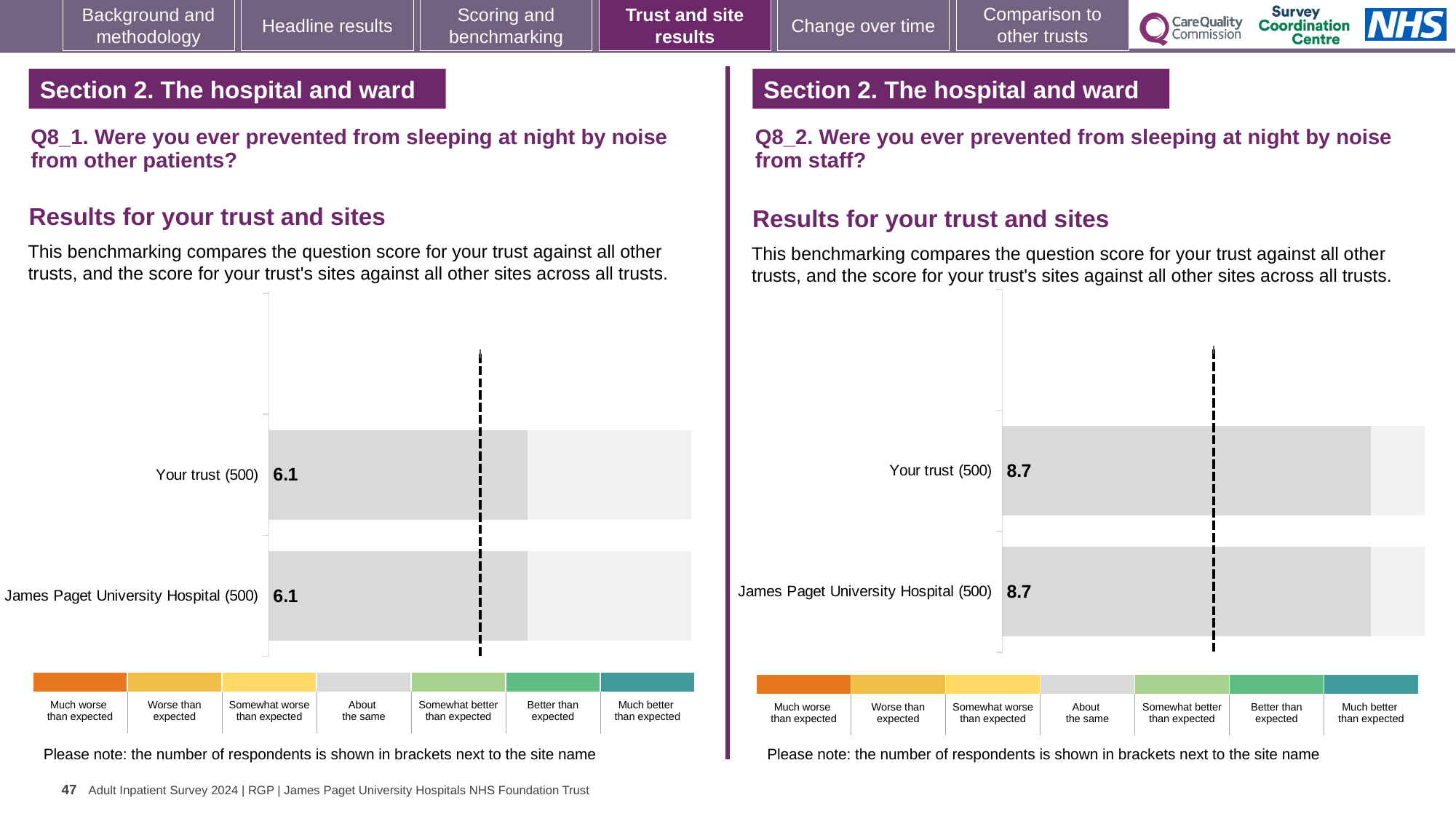
What is the difference between the Your trust score in the right chart (Q8_2) and the Your trust score in the left chart (Q8_1)? 2.6 What kind of chart is used in the left chart (Q8_1)? Bar chart In the left chart (Q8_1, noise from other patients), what is the score for James Paget University Hospital? 6.1 In the left chart (Q8_1), what is the difference between the score for Your trust and the score for James Paget University Hospital? 0 In the left chart (Q8_1, noise from other patients), what is the score for Your trust? 6.1 How many rating categories does the colour legend below the right chart (Q8_2) list? 7 Which is larger: the Your trust score in the left chart (Q8_1) or the Your trust score in the right chart (Q8_2)? Right chart (Q8_2) How many bars are plotted in the left chart (Q8_1)? 2 In the right chart (Q8_2, noise from staff), what is the score for James Paget University Hospital? 8.7 In the right chart (Q8_2, noise from staff), what is the score for Your trust? 8.7 How many bars are plotted in the right chart (Q8_2)? 2 In the left chart (Q8_1), how many respondents are shown in brackets next to Your trust? 500